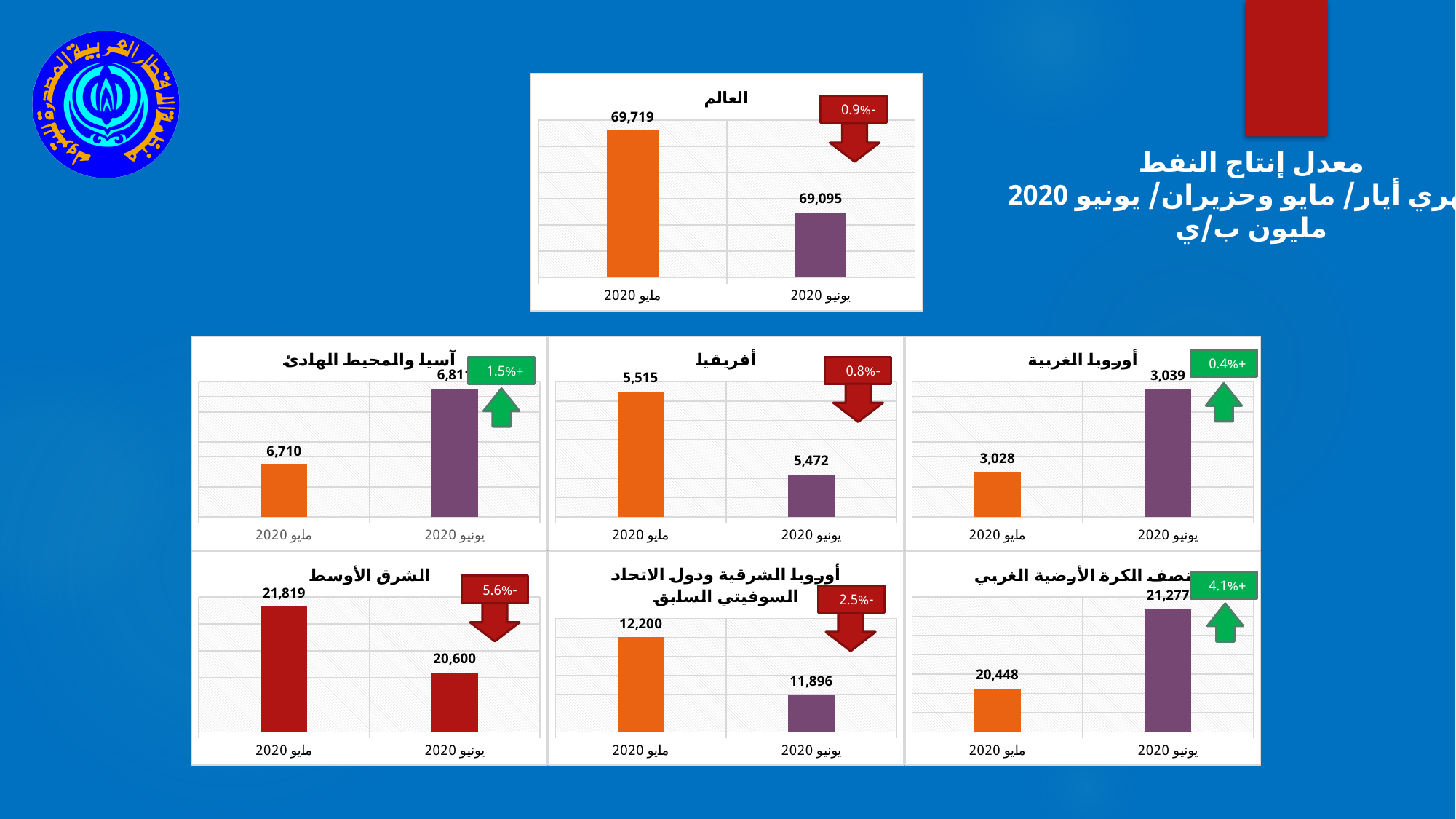
In the chart titled "أفريقيا" (Africa), do the values rise or fall from مايو 2020 to يونيو 2020? fall How many bars are plotted in the chart titled "آسيا والمحيط الهادئ" (Asia and the Pacific)? 2 In the chart titled "العالم" (World), what is the value for يونيو 2020 (June 2020)? 69,095 In the chart titled "العالم" (World), what is the difference between the May 2020 and June 2020 values? 624 In the chart titled "العالم" (World), what is the value for مايو 2020 (May 2020)? 69,719 What type of chart is the one titled "العالم" (World)? bar chart In the chart titled "أوروبا الشرقية ودول الاتحاد السوفيتي السابق" (Eastern Europe and former Soviet Union), what is the value for مايو 2020 (May 2020)? 12,200 In the chart titled "الشرق الأوسط" (Middle East), what is the value for يونيو 2020 (June 2020)? 20,600 In the chart titled "نصف الكرة الأرضية الغربي" (Western Hemisphere), what is the difference between the June 2020 and May 2020 values? 829 In the chart titled "الشرق الأوسط" (Middle East), which bar is higher, مايو 2020 or يونيو 2020? مايو 2020 In the chart titled "نصف الكرة الأرضية الغربي" (Western Hemisphere), what is the value for مايو 2020 (May 2020)? 20,448 In the chart titled "أوروبا الغربية" (Western Europe), what is the value for يونيو 2020 (June 2020)? 3,039